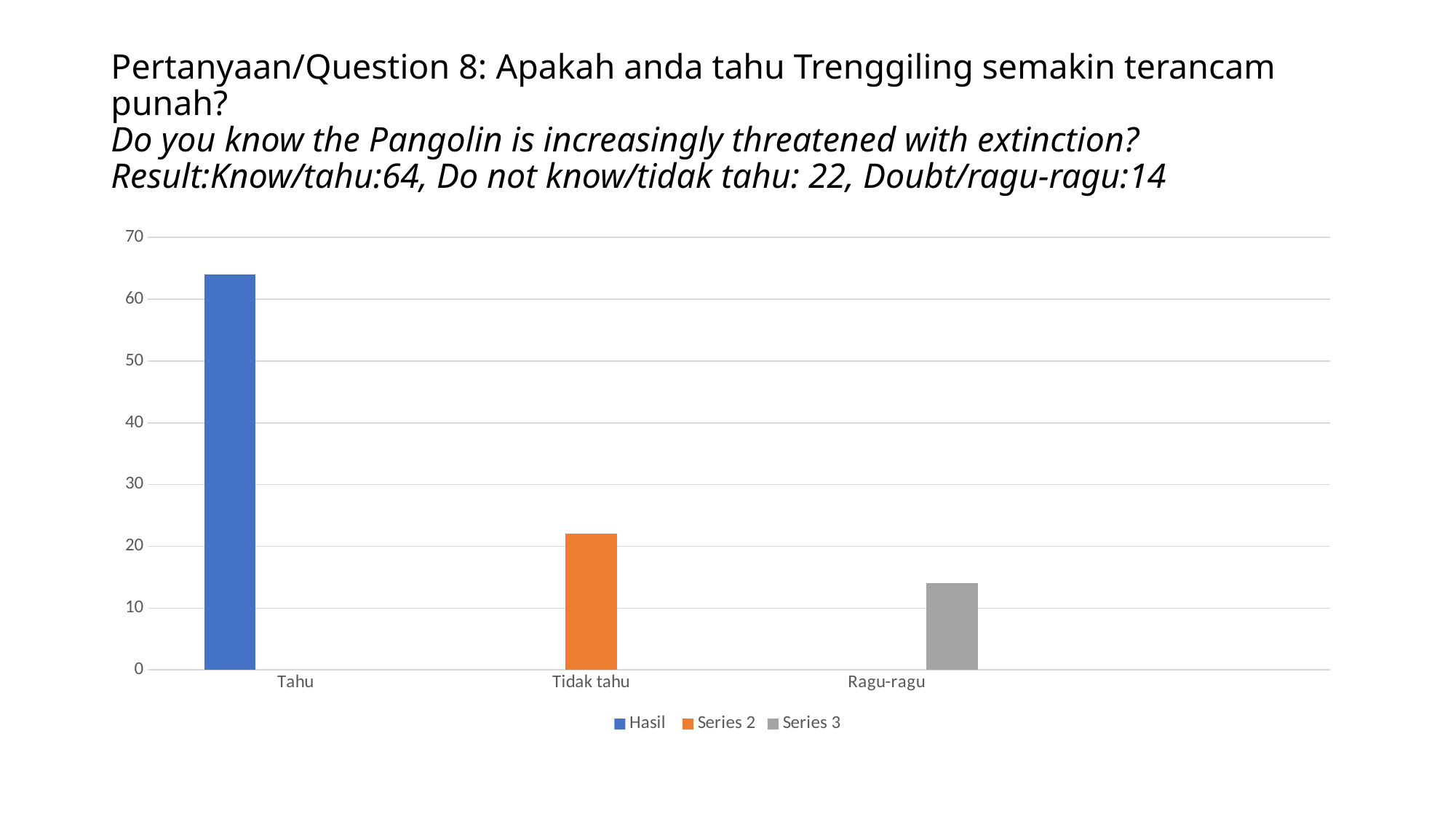
What is the value for Tahu? 64 Is the value for Tahu greater or less than 60? greater What is the value for Ragu-ragu? 14 What kind of chart is shown on the slide? bar chart Which category has the lowest value? Ragu-ragu What is the value for Tidak tahu? 22 What is the difference between the values for Tahu and Tidak tahu? 42 How many categories are shown on the x axis? 3 What is the difference between the values for Tidak tahu and Ragu-ragu? 8 How many series does the legend list? 3 Which category has the highest value? Tahu Which is larger, the value for Tidak tahu or the value for Ragu-ragu? Tidak tahu